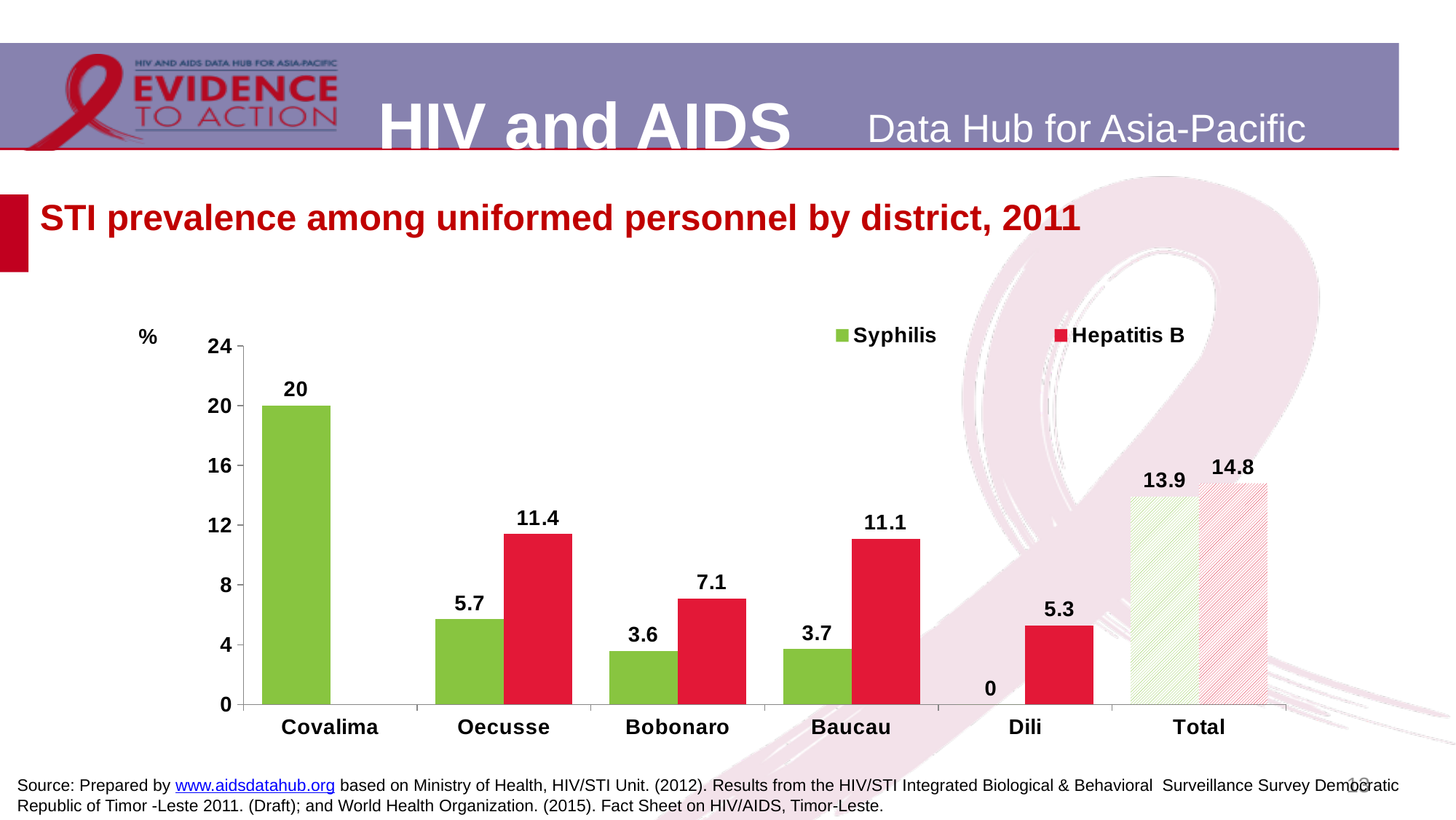
What kind of chart is shown on the slide? bar chart What is the Syphilis prevalence for Dili? 0 Which is larger for Baucau, the Syphilis value or the Hepatitis B value? Hepatitis B How many categories are shown on the x axis? 6 What is the Syphilis prevalence for Covalima? 20 What is the Hepatitis B value for Total? 14.8 What is the Hepatitis B prevalence for Oecusse? 11.4 Which district has the highest Syphilis prevalence? Covalima Among the districts (excluding Total), which has the lowest Hepatitis B prevalence shown? Dili Is the Hepatitis B value for Bobonaro greater or less than 8? less How many series does the legend list? 2 What is the difference between the Hepatitis B and Syphilis values for Oecusse? 5.7